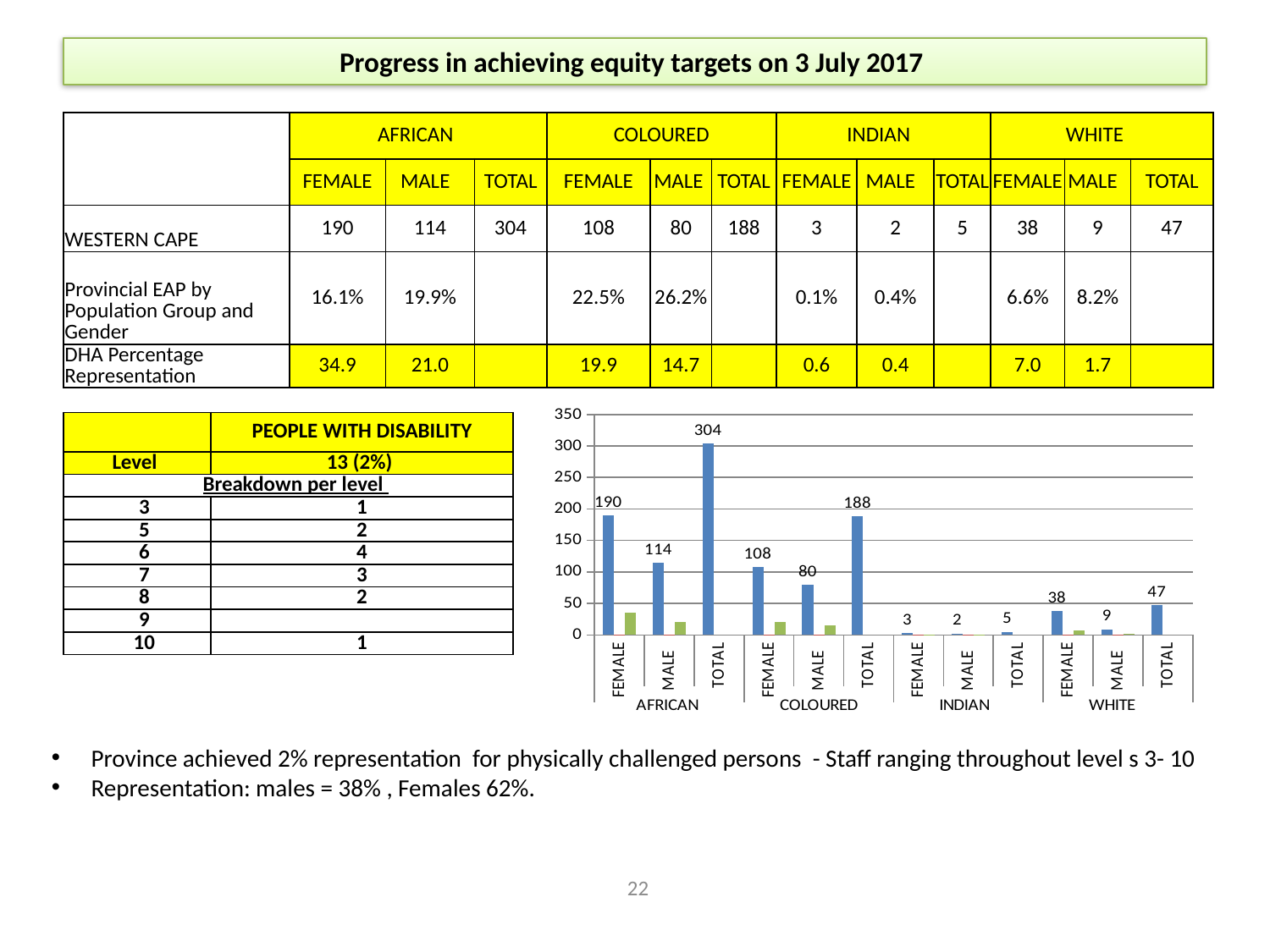
What kind of chart is shown on the slide? bar chart Which category has the highest labelled value in the chart? AFRICAN TOTAL What is the difference between the labelled values for AFRICAN FEMALE and AFRICAN MALE? 76 Which category has the lowest labelled value in the chart? INDIAN MALE How many population groups are shown along the x axis of the chart? 4 Is the labelled value for COLOURED MALE greater or less than 100? less What is the labelled value for WHITE MALE? 9 How many bars carry data labels in the chart? 12 Which is larger, the labelled value for COLOURED TOTAL or WHITE TOTAL? COLOURED TOTAL What is the labelled value for COLOURED FEMALE? 108 What is the value of the tallest bar for AFRICAN TOTAL? 304 What is the labelled value for INDIAN TOTAL? 5